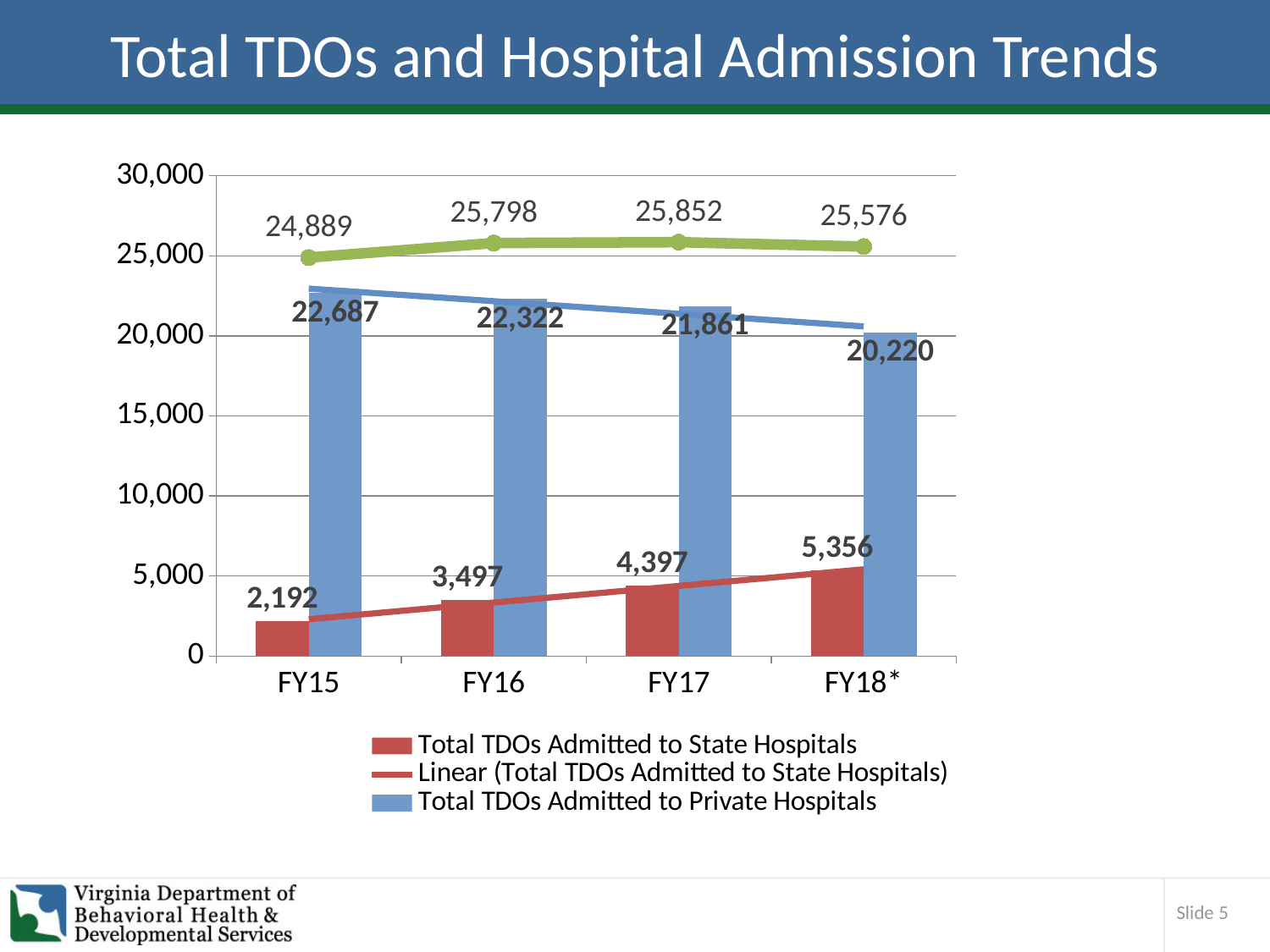
What is the value for Total TDOs Admitted to Private Hospitals in FY18*? 20,220 What is the value for Total TDOs Admitted to State Hospitals in FY17? 4,397 How many fiscal years are shown on the x axis? 4 Which is larger: Total TDOs Admitted to State Hospitals in FY16 or in FY17? FY17 What is the value for Total TDOs Admitted to Private Hospitals in FY16? 22,322 What is the value for Total TDOs Admitted to State Hospitals in FY15? 2,192 What is the difference between Total TDOs Admitted to Private Hospitals in FY15 and FY18*? 2,467 In which fiscal year is Total TDOs Admitted to Private Hospitals lowest? FY18* In which fiscal year is Total TDOs Admitted to State Hospitals highest? FY18* What is the difference between Total TDOs Admitted to State Hospitals in FY18* and FY15? 3,164 How many entries does the legend list? 3 Do the values for Total TDOs Admitted to State Hospitals rise or fall from FY15 to FY18*? rise